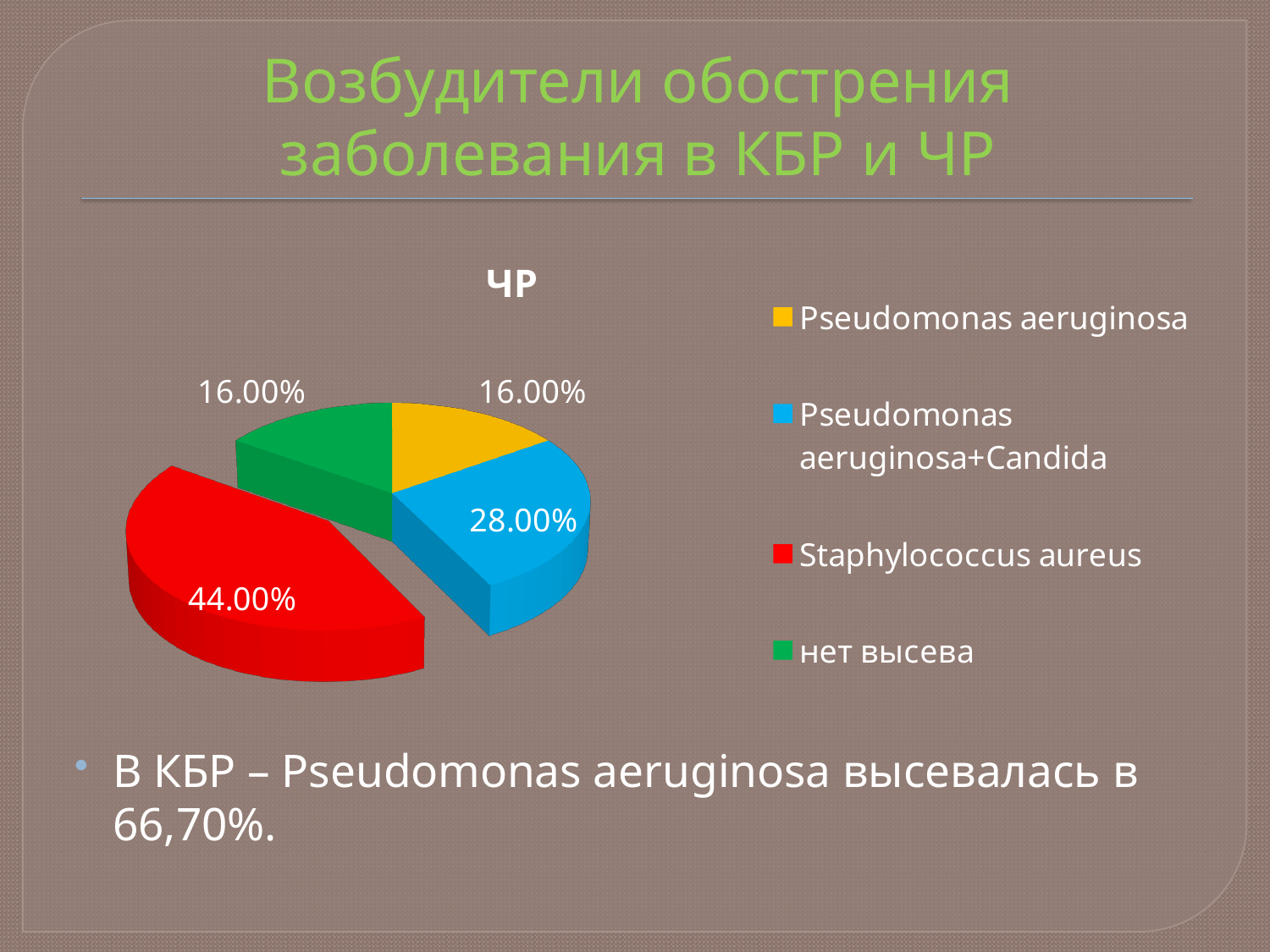
What is the difference between the shares of Staphylococcus aureus and Pseudomonas aeruginosa+Candida? 16.00% What share of the pie does Pseudomonas aeruginosa+Candida have? 28.00% What share of the pie does нет высева have? 16.00% How many entries does the legend list? 4 Which category has the largest slice of the pie? Staphylococcus aureus What share of the pie does Pseudomonas aeruginosa have? 16.00% What is the chart's title? ЧР What colour is the slice for Staphylococcus aureus? red How many slices does the pie chart have? 4 Which is larger, the share of Pseudomonas aeruginosa+Candida or the share of нет высева? Pseudomonas aeruginosa+Candida What share of the pie does Staphylococcus aureus have? 44.00% What kind of chart is shown on the slide? pie chart